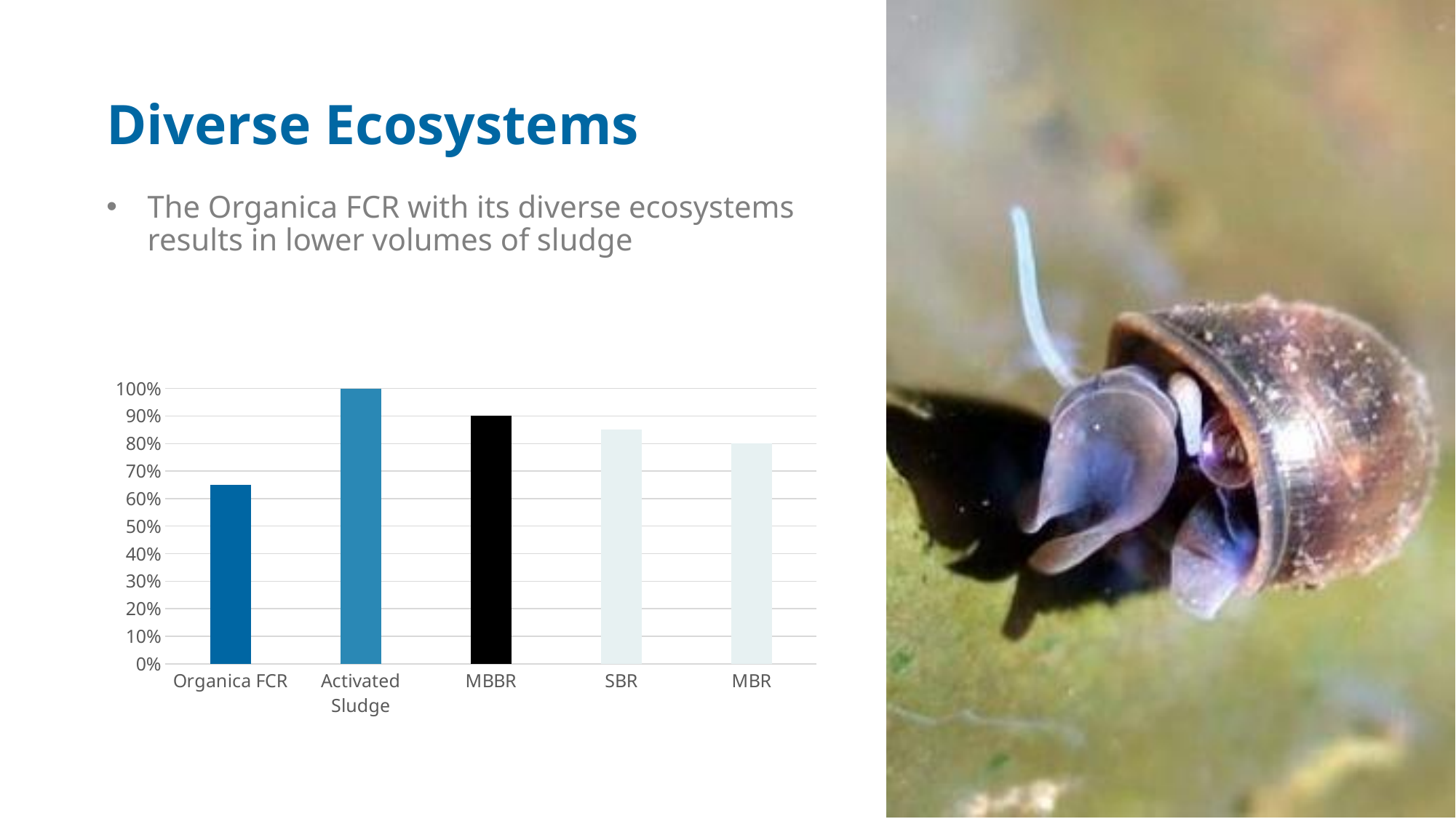
Is the value for Organica FCR greater or less than 70%? less What is the value for Activated Sludge? 100% Which category has the highest bar in the chart? Activated Sludge What colour is the bar for MBBR? black How many categories are shown on the x axis of the chart? 5 What kind of chart is shown on the slide? bar chart Is the value for SBR greater or less than 80%? greater What is the difference between the values for Activated Sludge and MBR? 20% What is the value for MBR? 80% Which is larger, the value for MBBR or the value for MBR? MBBR Which category has the lowest bar in the chart? Organica FCR What is the value for MBBR? 90%